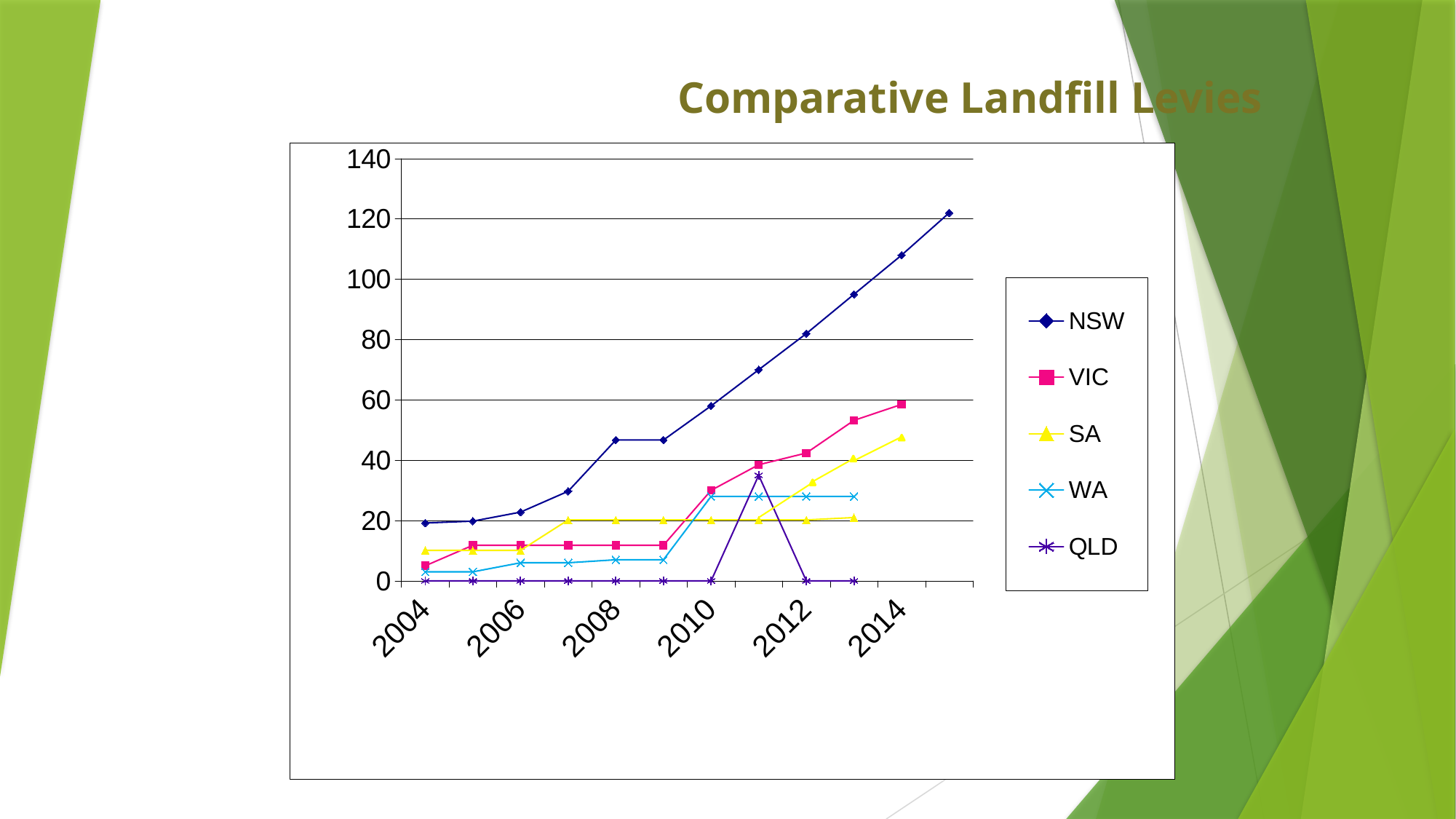
Which series has the highest value in 2014? NSW What is the title of the slide's chart? Comparative Landfill Levies In 2011, which is larger, QLD or WA? QLD Is the value for NSW in 2014 greater or less than 100? greater Which series has the lowest value in 2014? VIC Is the value for VIC in 2014 greater or less than 40? greater Is the value for NSW in 2008 greater or less than 40? greater How many series does the legend list? 5 Does the NSW series rise or fall from 2004 to 2014? rise What kind of chart is shown on the slide? line chart